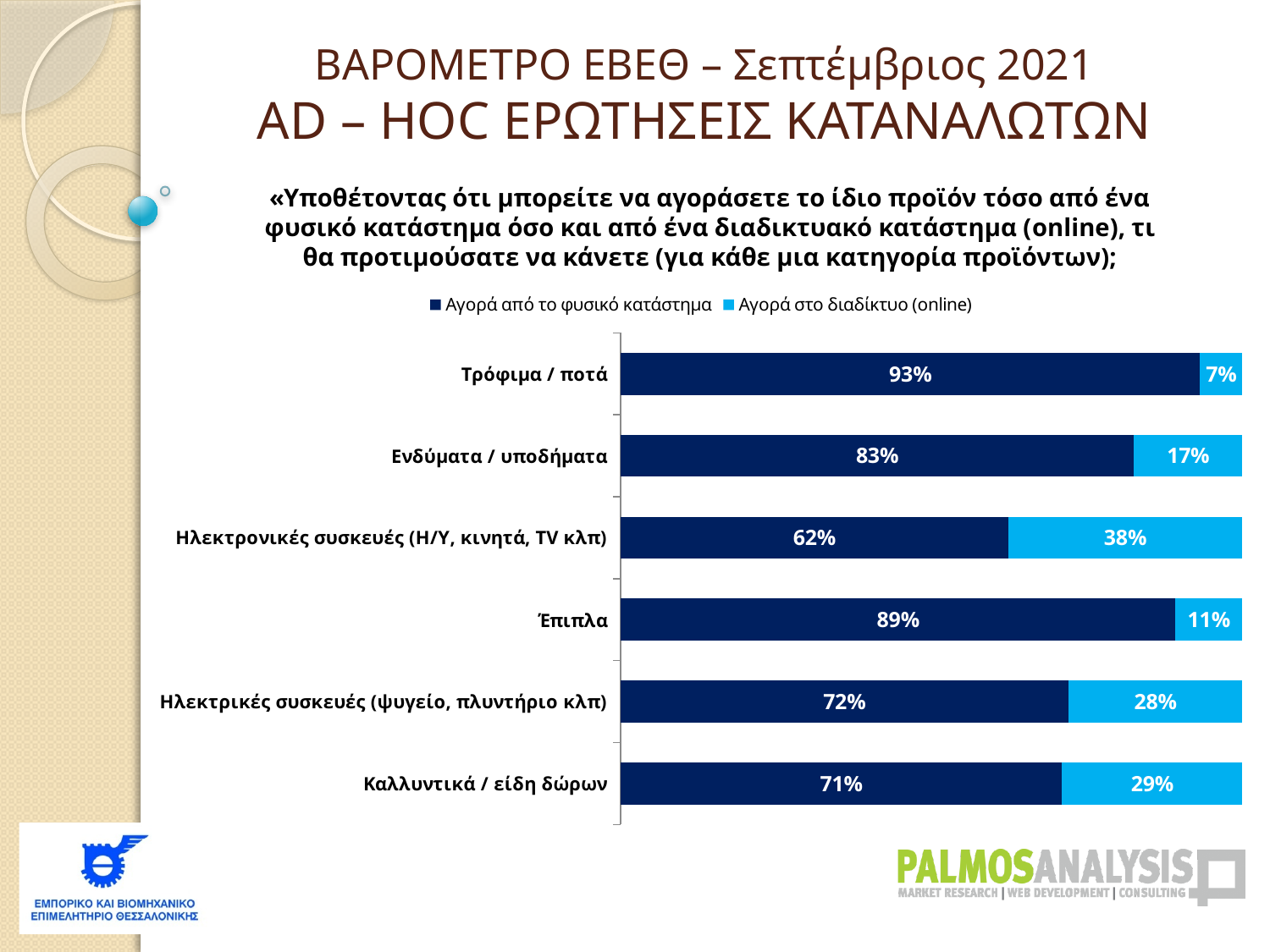
What is the value for Αγορά στο διαδίκτυο (online) for Καλλυντικά / είδη δώρων? 29% Which product category has the highest share for Αγορά από το φυσικό κατάστημα? Τρόφιμα / ποτά Which is larger: the online share for Ηλεκτρικές συσκευές (ψυγείο, πλυντήριο κλπ) or for Καλλυντικά / είδη δώρων? Καλλυντικά / είδη δώρων What is the difference between the physical store share for Ενδύματα / υποδήματα and for Έπιπλα? 6% Which product category has the highest share for Αγορά στο διαδίκτυο (online)? Ηλεκτρονικές συσκευές (Η/Υ, κινητά, TV κλπ) What kind of chart is shown on the slide? Stacked bar chart How many product categories are shown in the chart? 6 What percentage of respondents prefer to buy Τρόφιμα / ποτά from the physical store (Αγορά από το φυσικό κατάστημα)? 93% What percentage of respondents prefer to buy Ηλεκτρονικές συσκευές (Η/Υ, κινητά, TV κλπ) online (Αγορά στο διαδίκτυο)? 38% Which product category has the lowest share for Αγορά από το φυσικό κατάστημα? Ηλεκτρονικές συσκευές (Η/Υ, κινητά, TV κλπ) What is the total of the stacked bar for Έπιπλα? 100% How many series does the legend list? 2